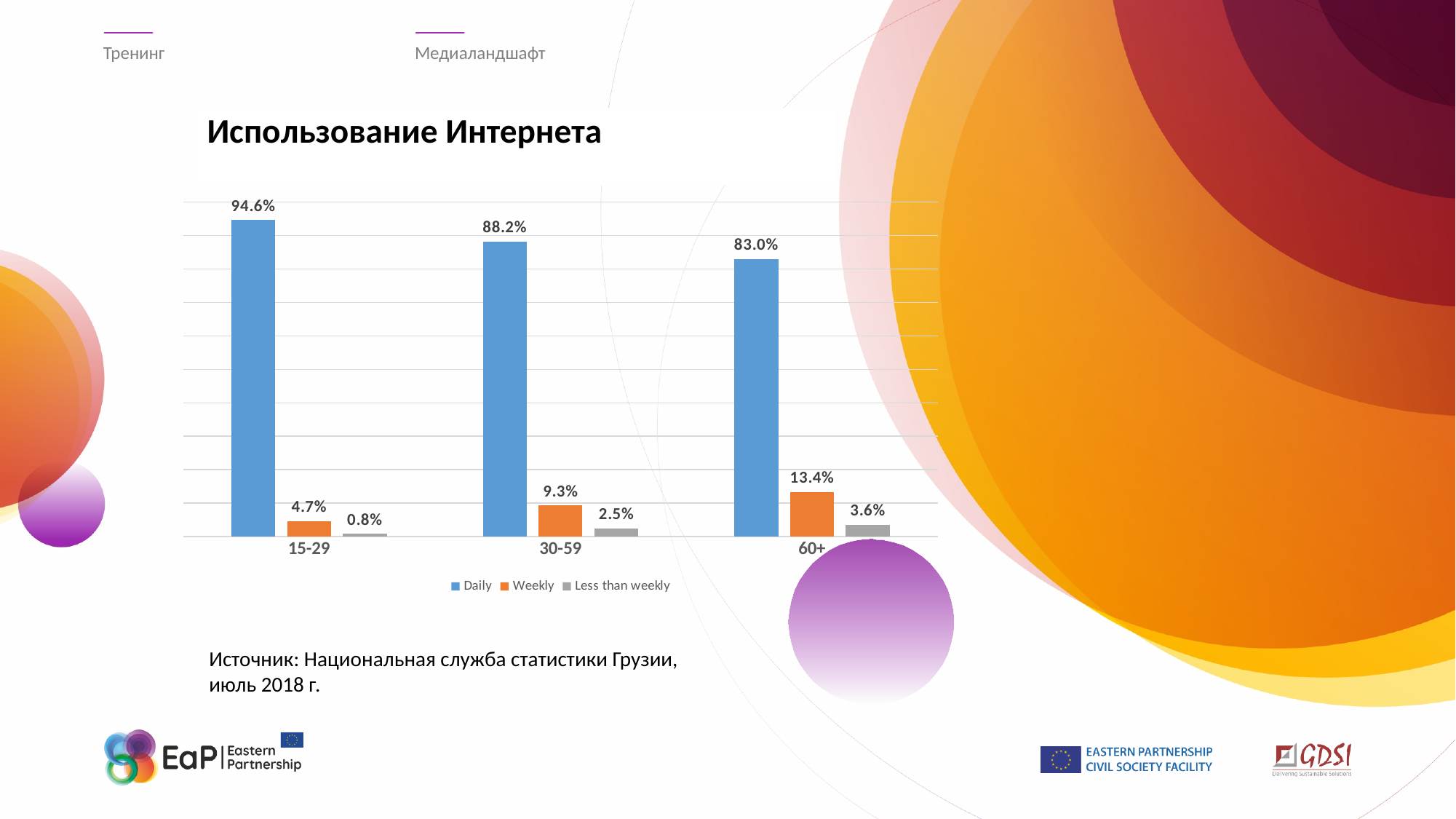
Which age group has the highest Daily value? 15-29 Which age group has the lowest Less than weekly value? 15-29 What is the Daily value for the 15-29 age group? 94.6% What is the difference between the Daily values for 15-29 and 60+? 11.6% What is the Less than weekly value for the 30-59 age group? 2.5% Which is larger, the Weekly value for 30-59 or the Weekly value for 60+? 60+ What is the Weekly value for the 60+ age group? 13.4% How many series does the legend list? 3 What is the title of the chart? Использование Интернета How many age groups are shown on the x axis? 3 Do the Daily values rise or fall from the 15-29 group to the 60+ group? Fall What kind of chart is shown on the slide? Bar chart